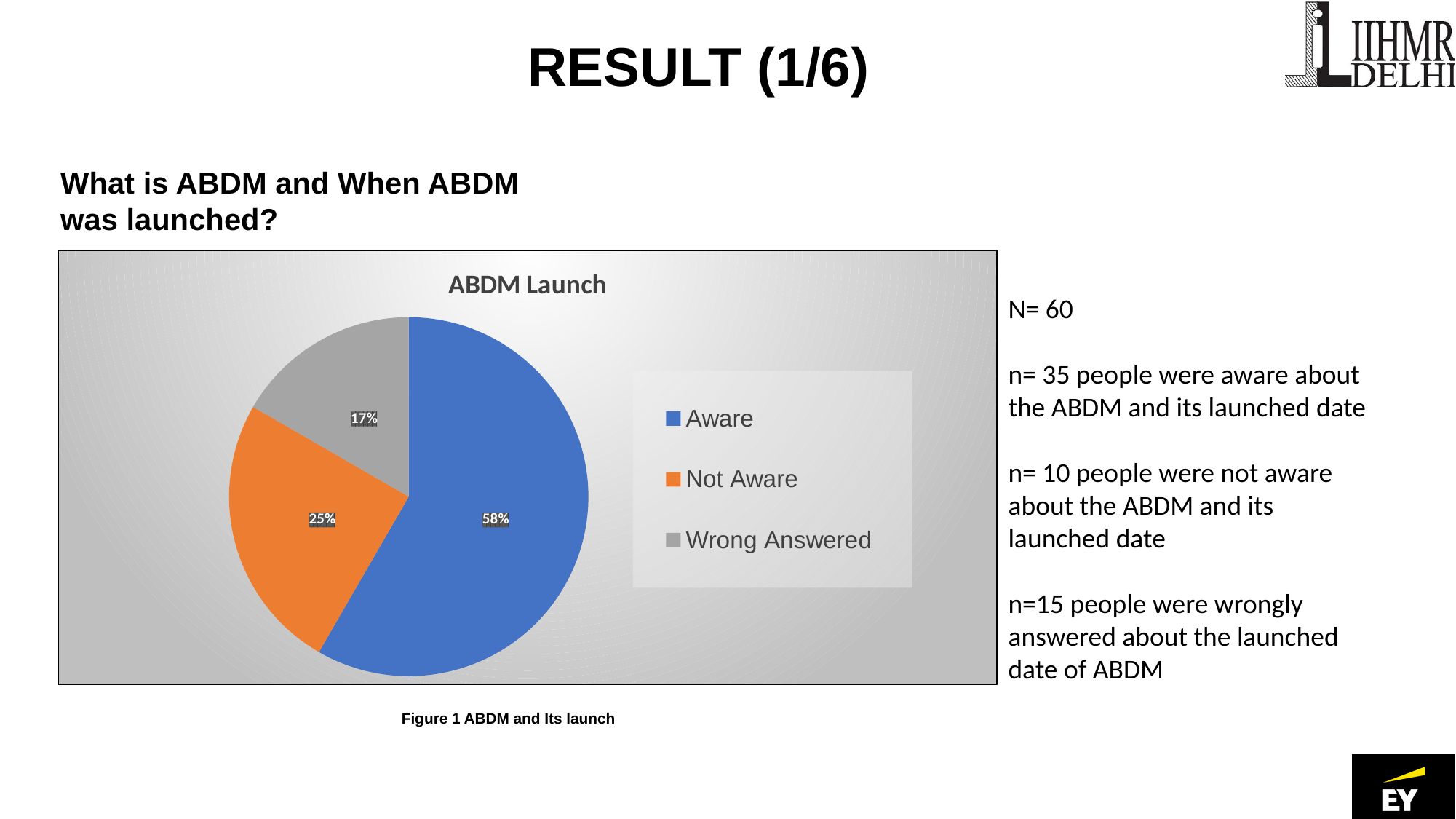
What is the title of the chart? ABDM Launch What share of the pie does the Aware slice represent? 58% Which slice is larger, Not Aware or Wrong Answered? Not Aware What share of the pie does the Not Aware slice represent? 25% What kind of chart is shown on the slide? pie chart What share of the pie does the Wrong Answered slice represent? 17% What colour is the Not Aware slice? orange What is the difference in percentage points between the Not Aware and Wrong Answered slices? 8 Which category has the largest slice of the pie? Aware Which category has the smallest slice of the pie? Wrong Answered How many categories does the pie chart show? 3 What is the difference in percentage points between the Aware and Not Aware slices? 33